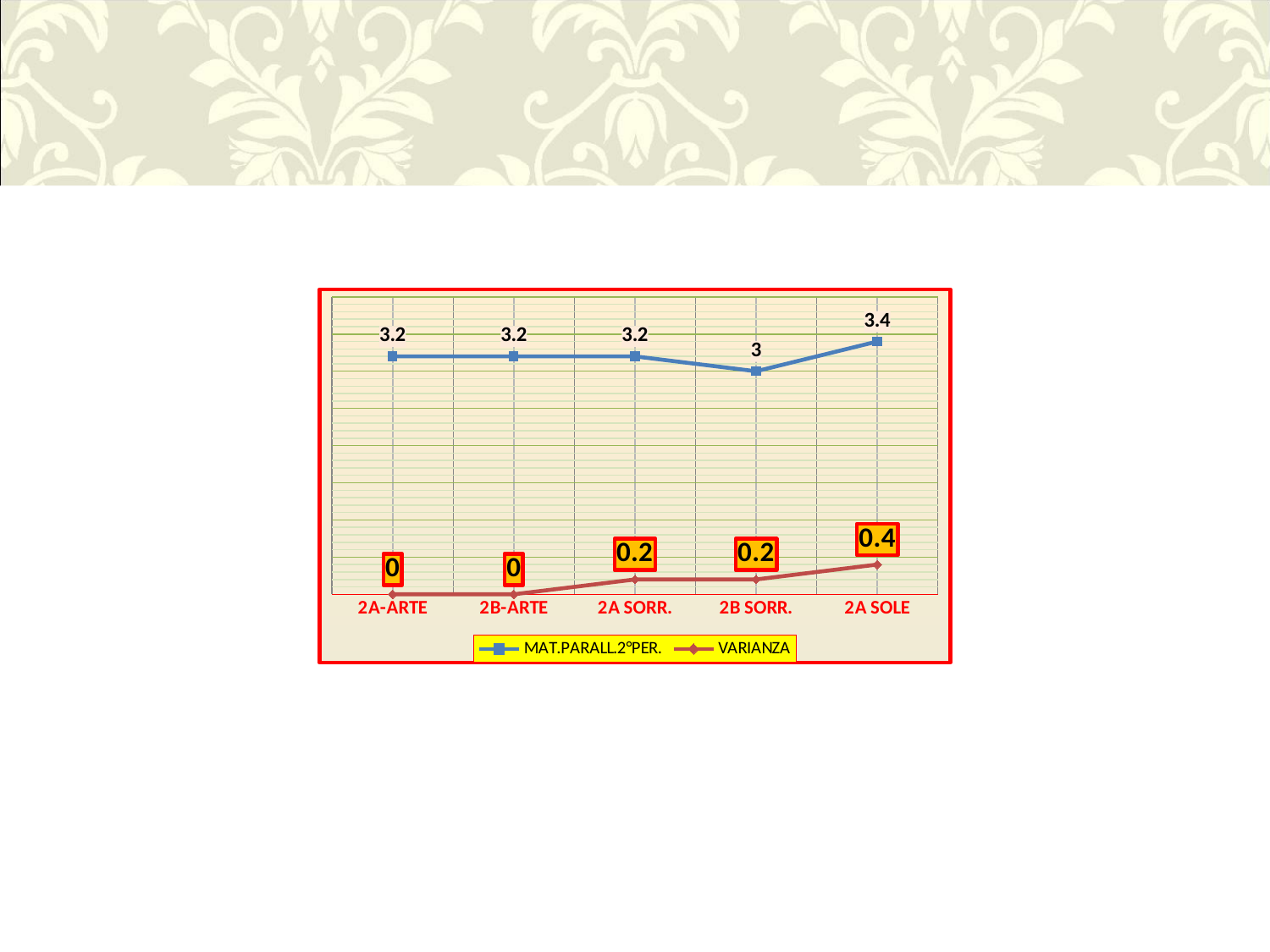
What is the VARIANZA value for 2A SOLE? 0.4 What kind of chart is shown on the slide? Line chart How many categories are shown on the x axis? 5 Which is larger, the VARIANZA value for 2A SOLE or for 2B SORR.? 2A SOLE How many series does the legend list? 2 What is the MAT.PARALL.2°PER. value for 2B SORR.? 3 Which category has the highest MAT.PARALL.2°PER. value? 2A SOLE What is the difference between the MAT.PARALL.2°PER. values for 2A SOLE and 2B SORR.? 0.4 What is the VARIANZA value for 2A SORR.? 0.2 Which category has the lowest MAT.PARALL.2°PER. value? 2B SORR. Does the VARIANZA series rise or fall from 2A-ARTE to 2A SOLE? Rise What is the MAT.PARALL.2°PER. value for 2A SOLE? 3.4